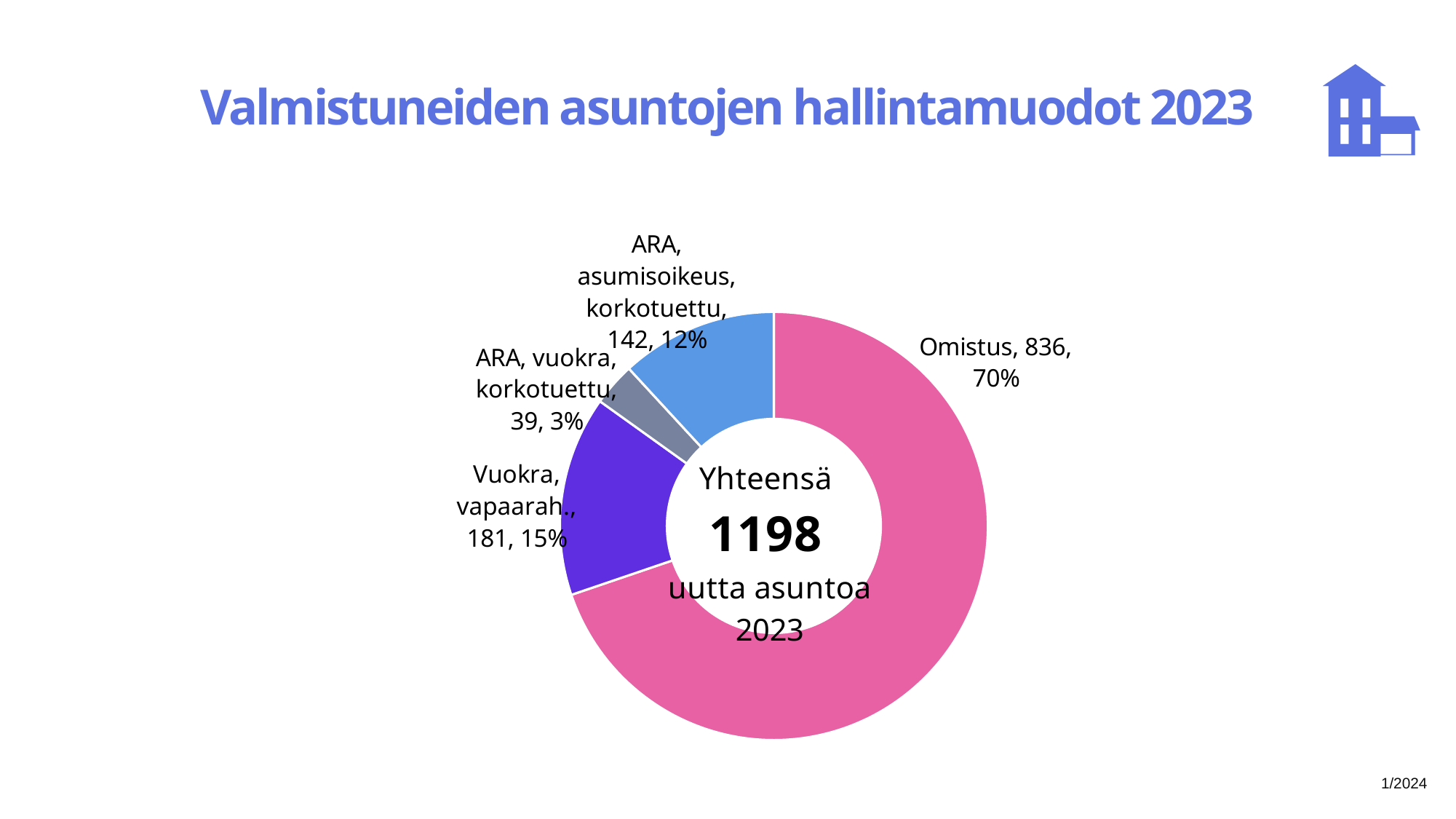
What share of the pie does Omistus represent? 70% Which is larger, Vuokra, vapaarah. or ARA, asumisoikeus, korkotuettu? Vuokra, vapaarah. What is the value for Omistus? 836 What is the difference between the values for Omistus and Vuokra, vapaarah.? 655 What share of the pie does ARA, asumisoikeus, korkotuettu represent? 12% What total is shown in the centre of the chart? 1198 What is the value for ARA, vuokra, korkotuettu? 39 What kind of chart is shown on the slide? Pie chart (doughnut) Which category has the smallest slice? ARA, vuokra, korkotuettu What is the value for ARA, asumisoikeus, korkotuettu? 142 Which category has the largest slice? Omistus What is the value for Vuokra, vapaarah.? 181